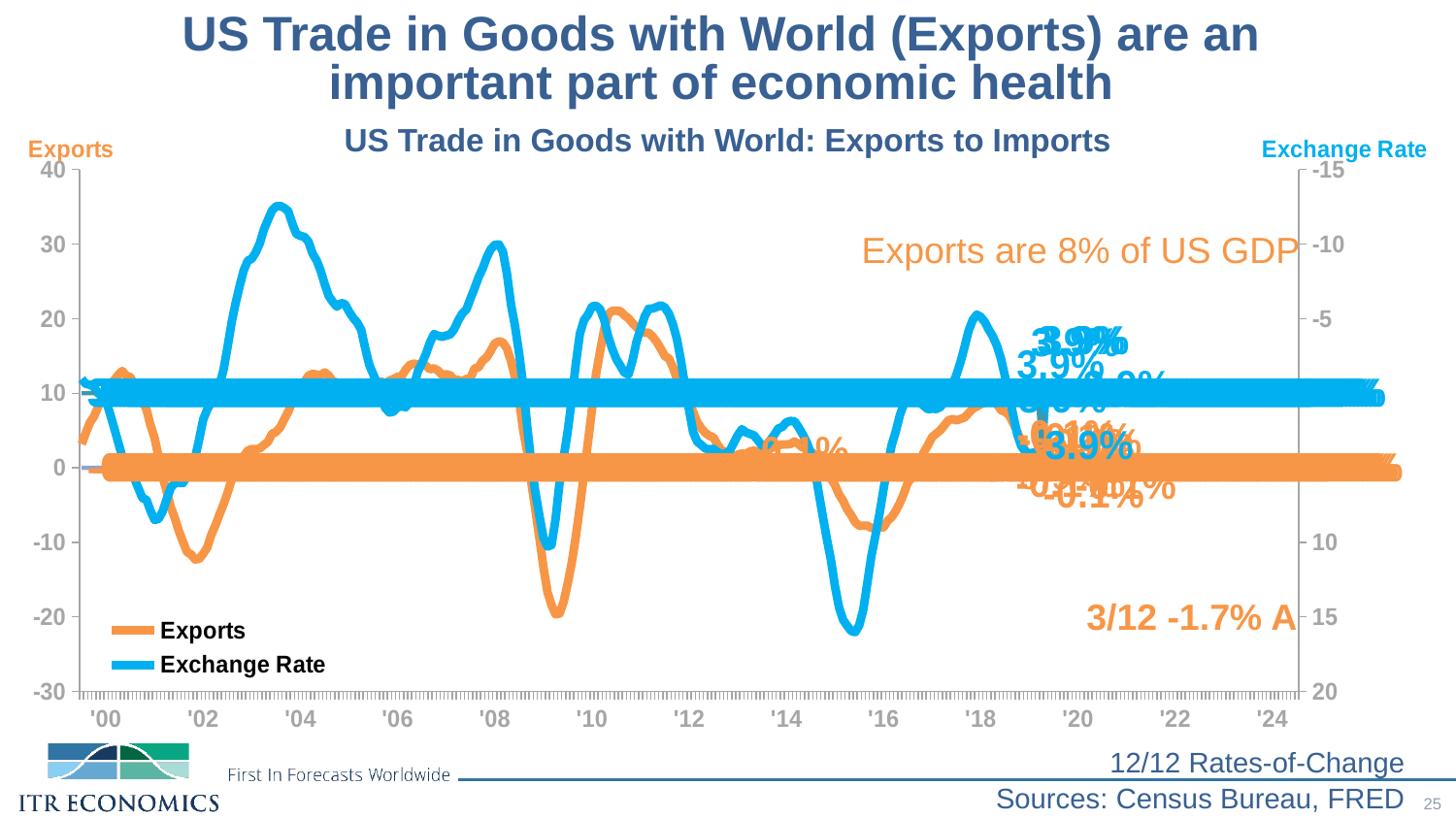
What kind of chart is shown on the slide? Line chart What is the title of the chart? US Trade in Goods with World: Exports to Imports According to the annotation on the chart, what share of US GDP are exports? 8% Does the Exports line rise or fall between '09 and '10? rise What 3/12 rate-of-change value is annotated on the chart? -1.7% Does the Exports line rise or fall between '08 and '09? fall What is the highest value shown on the left (Exports) axis? 40 What are the two series named in the chart legend? Exports and Exchange Rate Is the Exports value around '09 greater or less than -10? less Is the Exports value around '02 greater or less than 0? less How many series does the chart legend list? 2